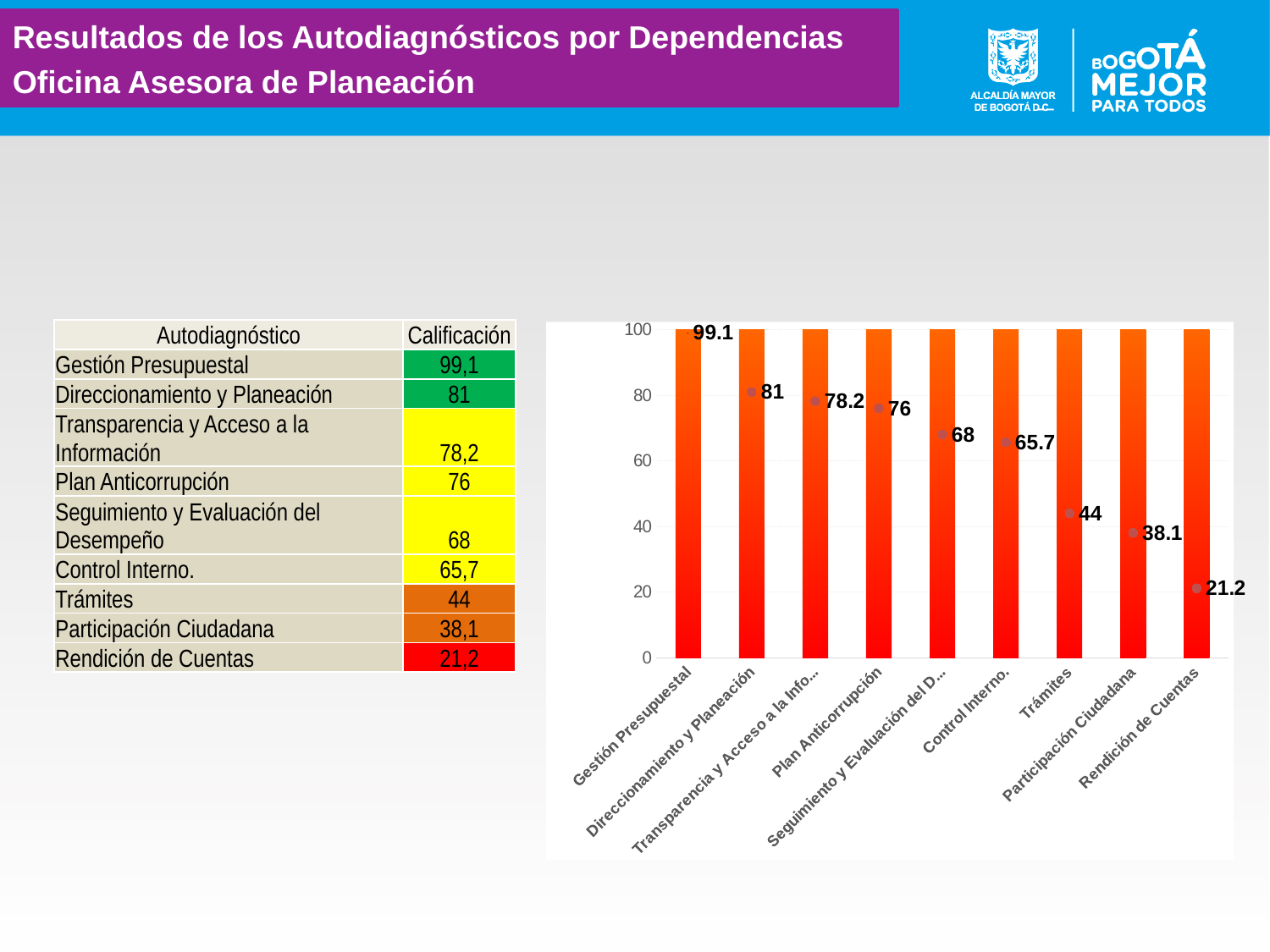
What is the difference between the values for Gestión Presupuestal and Rendición de Cuentas? 77.9 Which is larger, the value for Seguimiento y Evaluación del D... or the value for Control Interno.? Seguimiento y Evaluación del D... What is the value shown for Control Interno. in the chart? 65.7 How many categories are shown on the x axis of the chart? 9 Do the plotted values rise or fall from left to right along the x axis? fall Is the value for Participación Ciudadana greater or less than 40? less What is the difference between the values for Direccionamiento y Planeación and Plan Anticorrupción? 5 What is the value shown for Trámites in the chart? 44 Which category has the lowest value in the chart? Rendición de Cuentas What is the value shown for Gestión Presupuestal in the chart? 99.1 Which category has the highest value in the chart? Gestión Presupuestal What is the value shown for Participación Ciudadana in the chart? 38.1